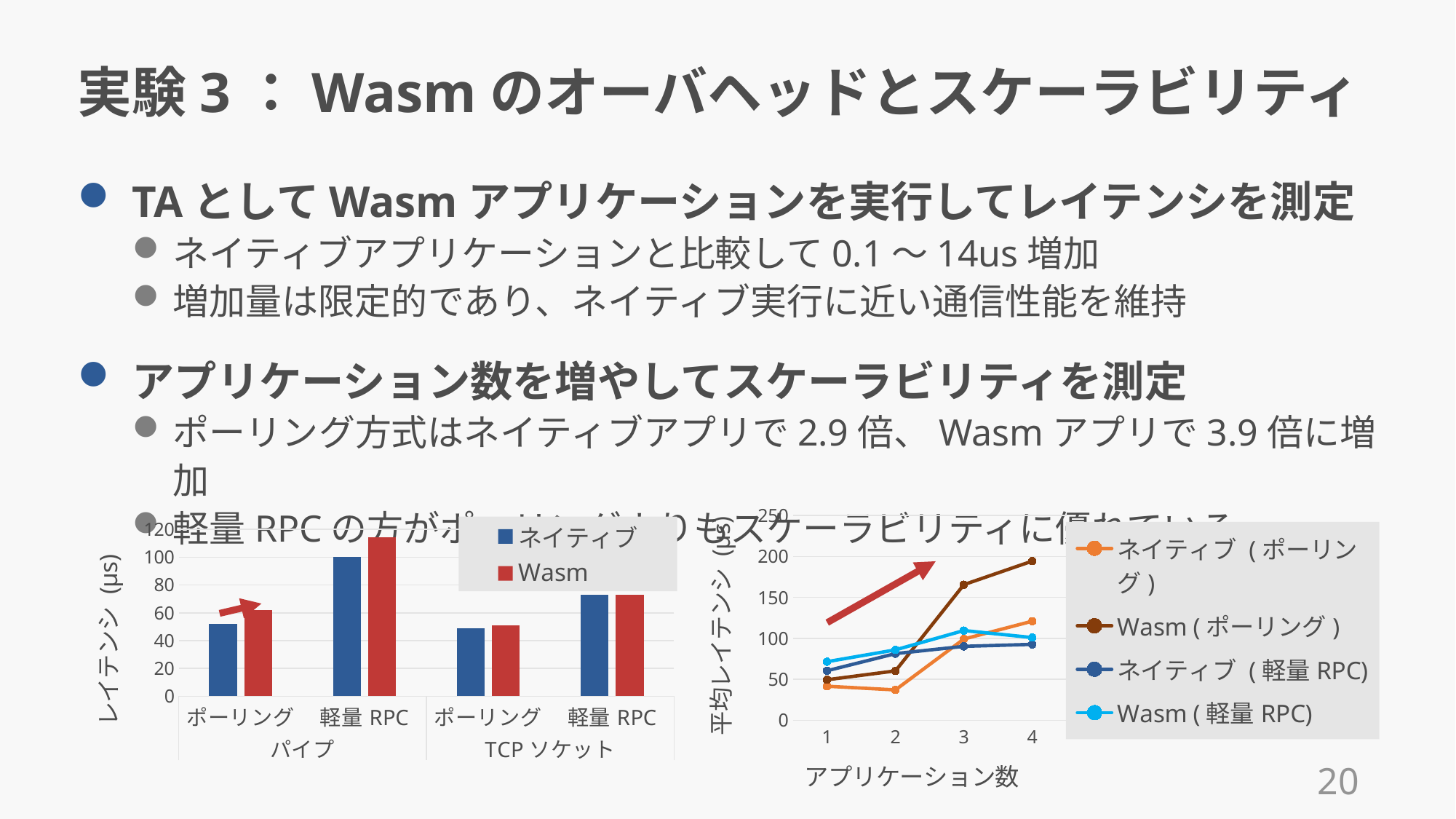
In the right line chart, does the Wasm ( ポーリング ) series rise or fall as アプリケーション数 increases from 1 to 4? rise What kind of chart is the chart on the left of the slide? bar chart What kind of chart is the chart on the right of the slide? line chart What is the x-axis label of the right line chart? アプリケーション数 In the left bar chart, which bar is the highest? Wasm, 軽量 RPC (パイプ) In the right line chart, how many values of アプリケーション数 are plotted on the x axis? 4 How many series does the legend of the left bar chart list? 2 How many series does the legend of the right line chart list? 4 In the left bar chart, for 軽量 RPC under パイプ, which is larger: ネイティブ or Wasm? Wasm In the right line chart, which series has the highest value at アプリケーション数 = 4? Wasm ( ポーリング ) In the left bar chart, is the Wasm value for 軽量 RPC under パイプ greater or less than 100? greater In the left bar chart, is the ネイティブ value for ポーリング under パイプ greater or less than 60? less